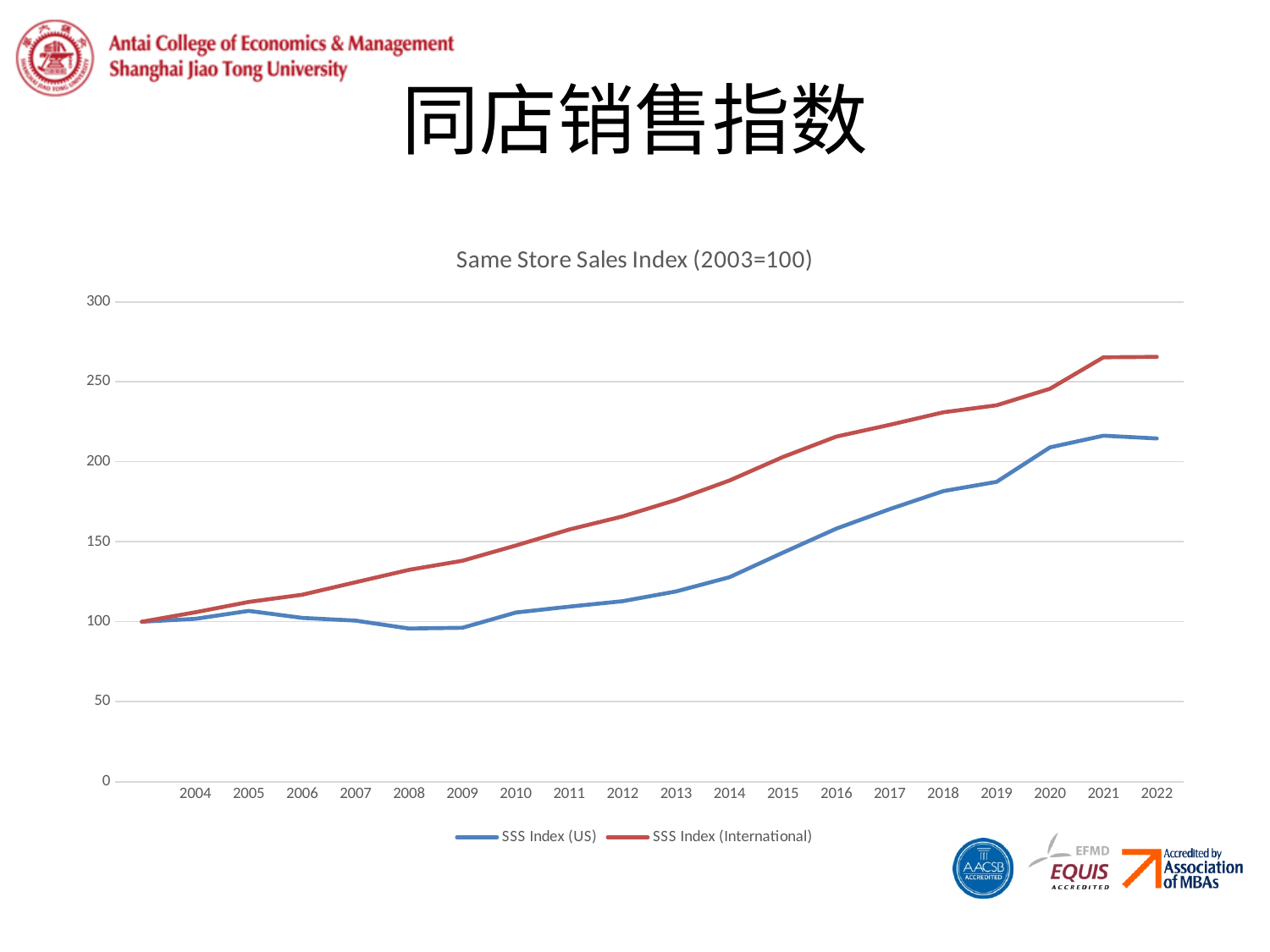
Does the SSS Index (International) line generally rise or fall from 2004 to 2022? Rise Is the value for SSS Index (US) in 2008 greater or less than 100? less In 2022, which series has the higher value, SSS Index (US) or SSS Index (International)? SSS Index (International) Is the value for SSS Index (US) in 2019 greater or less than 200? less Is the value for SSS Index (US) in 2022 greater or less than 200? greater What kind of chart is shown on the slide? Line chart Which colour is used for the SSS Index (International) line? Red How many series does the legend list? 2 What is the title of the chart? Same Store Sales Index (2003=100)